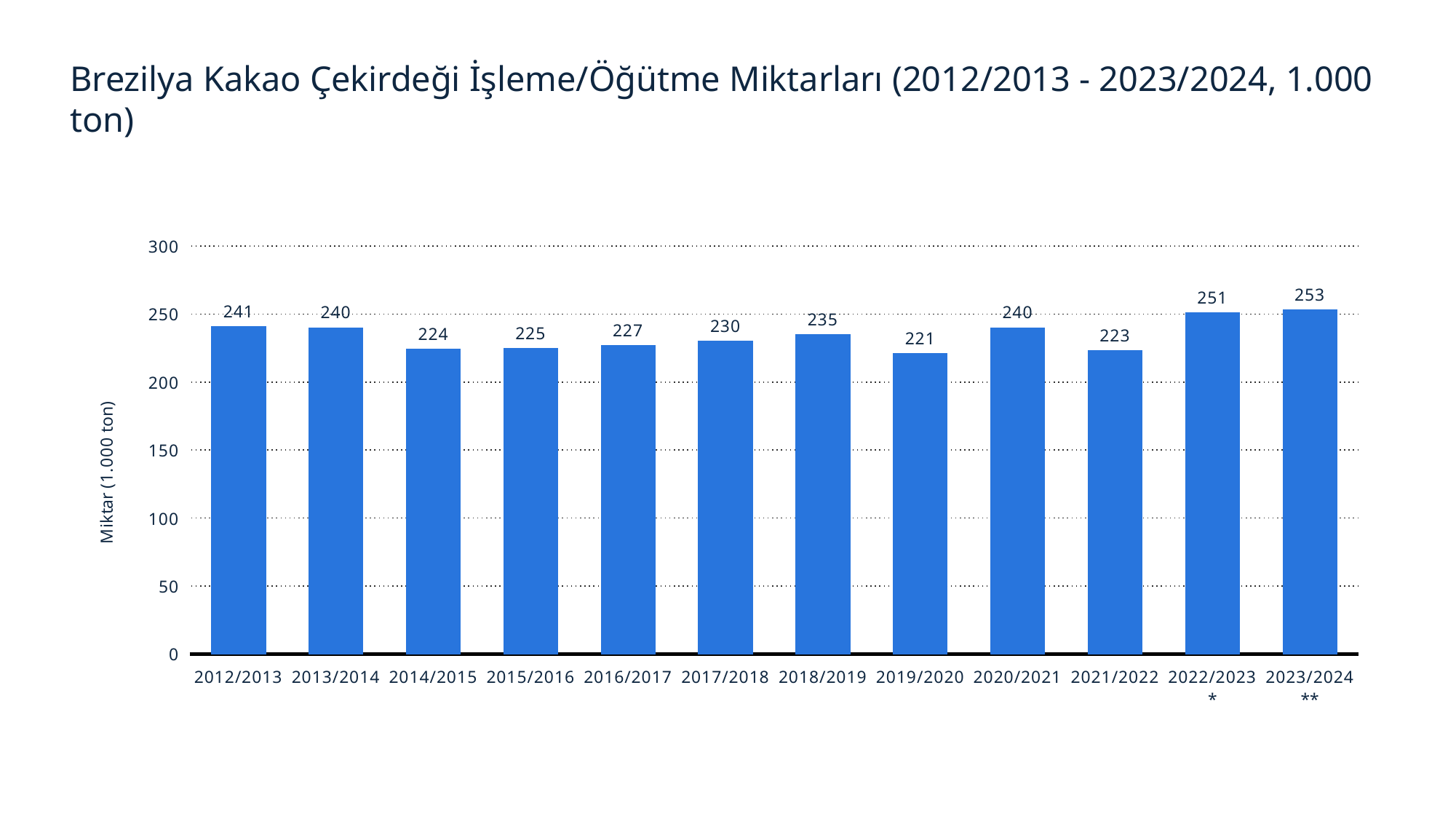
Which season has the highest value? 2023/2024 Do the values rise or fall from 2019/2020 to 2020/2021? rise What kind of chart is shown on the slide? bar chart Is the value for 2022/2023 greater or less than 200? greater Which is larger, the value for 2018/2019 or the value for 2021/2022? 2018/2019 What is the value for 2019/2020? 221 What is the difference between the values for 2023/2024 and 2019/2020? 32 What is the value for 2012/2013? 241 What is the value for 2017/2018? 230 Which season has the lowest value? 2019/2020 How many seasons are shown on the x axis? 12 What is the label of the y axis? Miktar (1.000 ton)